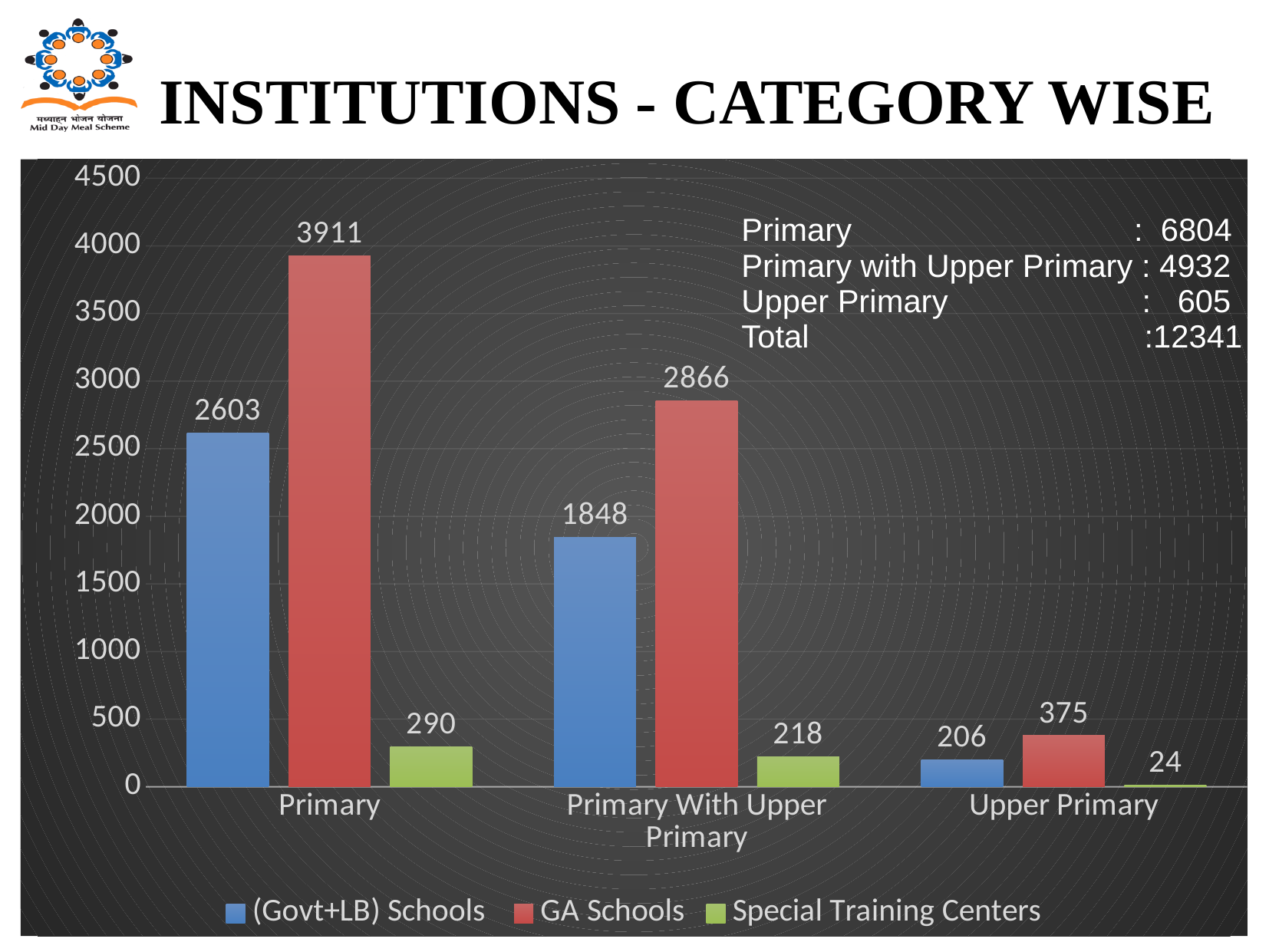
Which category has the highest value for GA Schools? Primary How many categories are shown on the x axis? 3 Do the values for Special Training Centers rise or fall from Primary to Upper Primary? Fall What kind of chart is shown on the slide? Bar chart How many series does the legend list? 3 What is the value for (Govt+LB) Schools in the Primary With Upper Primary category? 1848 What is the value for GA Schools in the Primary category? 3911 What is the value for Special Training Centers in the Upper Primary category? 24 Which is larger in the Upper Primary category: GA Schools or (Govt+LB) Schools? GA Schools What is the difference between GA Schools and (Govt+LB) Schools in the Primary category? 1308 Is the value for (Govt+LB) Schools in the Primary category greater or less than 2500? greater Which category has the lowest value for (Govt+LB) Schools? Upper Primary